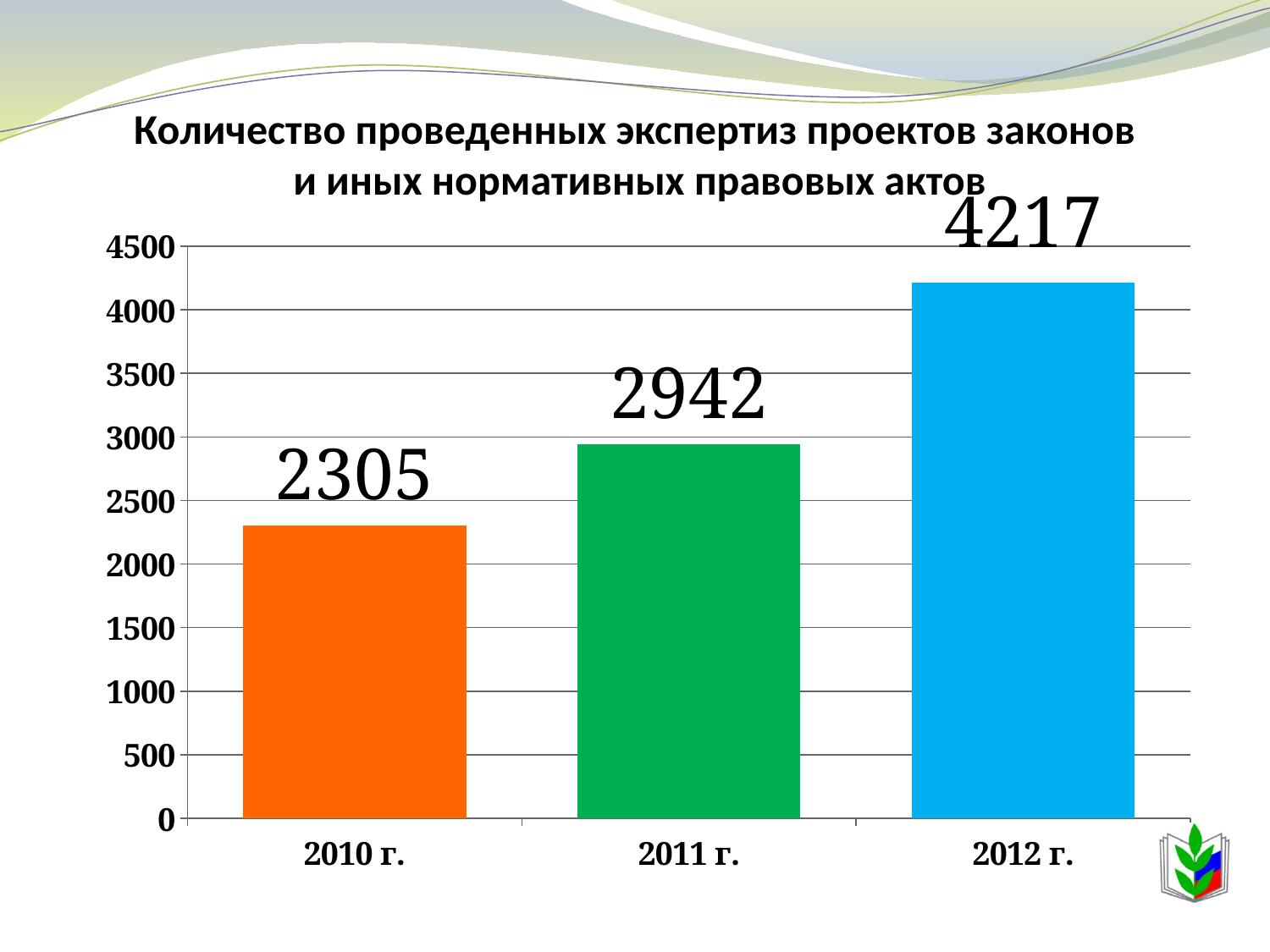
What is the value for 2012 г.? 4217 Is the value for 2012 г. greater or less than 4000? greater What is the difference between the values for 2012 г. and 2011 г.? 1275 How many years are shown on the chart? 3 What is the difference between the values for 2011 г. and 2010 г.? 637 What is the value for 2011 г.? 2942 Which year has the highest value? 2012 г. Which year has the lowest value? 2010 г. Do the values rise or fall from 2010 г. to 2012 г.? rise What kind of chart is shown on the slide? bar chart What is the value for 2010 г.? 2305 Which is larger, the value for 2010 г. or the value for 2011 г.? 2011 г.